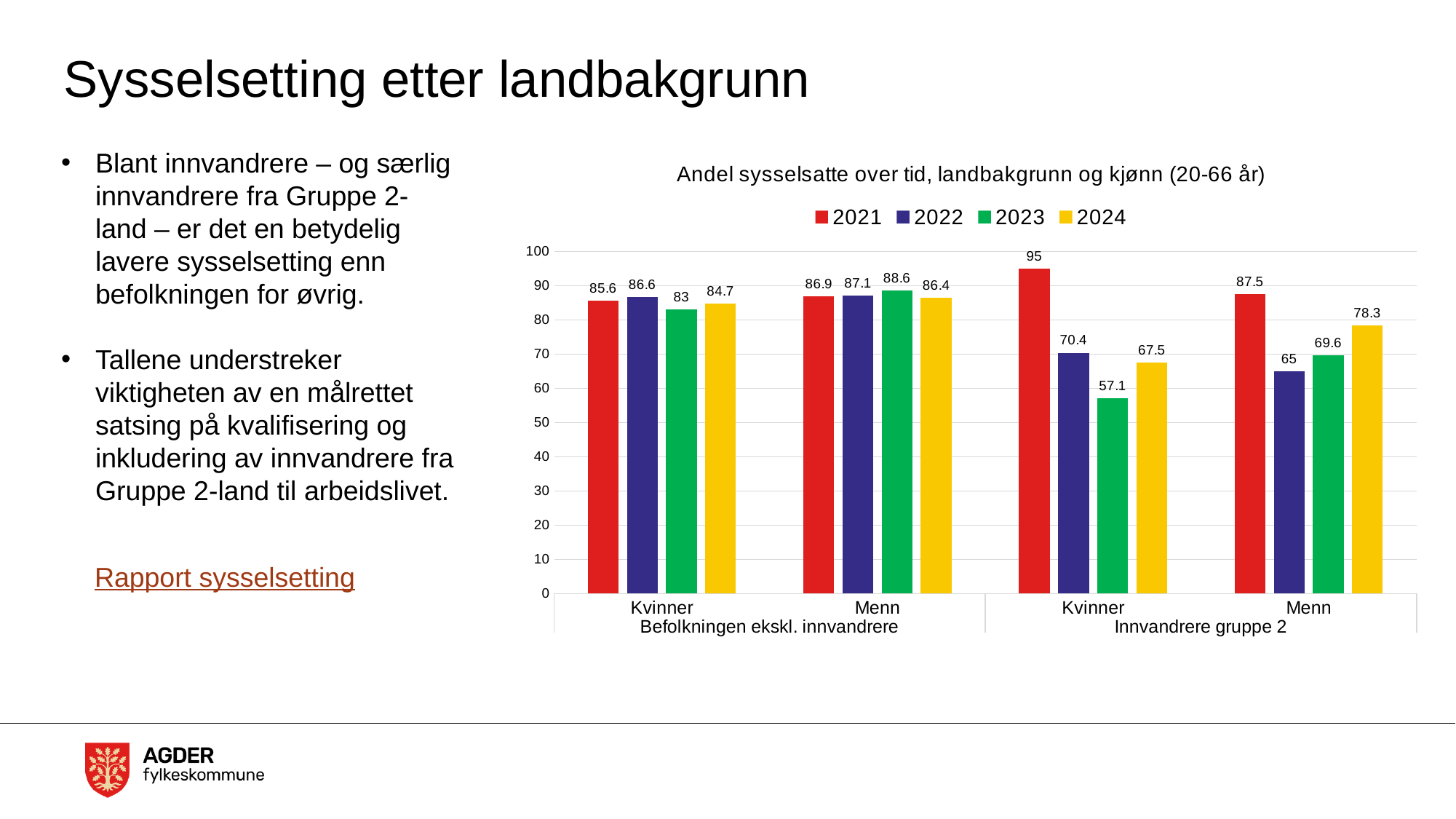
Which year has the highest value for Menn in the Innvandrere gruppe 2 group? 2021 How many series does the legend list? 4 How many category groups are shown along the x axis? 4 Which is larger: the 2024 value for Menn in Innvandrere gruppe 2 or the 2024 value for Kvinner in Innvandrere gruppe 2? Menn in Innvandrere gruppe 2 What is the title of the chart? Andel sysselsatte over tid, landbakgrunn og kjønn (20-66 år) Which year has the lowest value for Kvinner in the Befolkningen ekskl. innvandrere group? 2023 What is the difference between the 2021 and 2023 values for Kvinner in the Innvandrere gruppe 2 group? 37.9 What is the 2023 value for Kvinner in the Innvandrere gruppe 2 group? 57.1 What is the 2024 value for Menn in the Befolkningen ekskl. innvandrere group? 86.4 Is the 2022 value for Menn in the Innvandrere gruppe 2 group greater or less than 70? less What is the 2021 value for Kvinner in the Innvandrere gruppe 2 group? 95 What kind of chart is shown on the slide? Bar chart